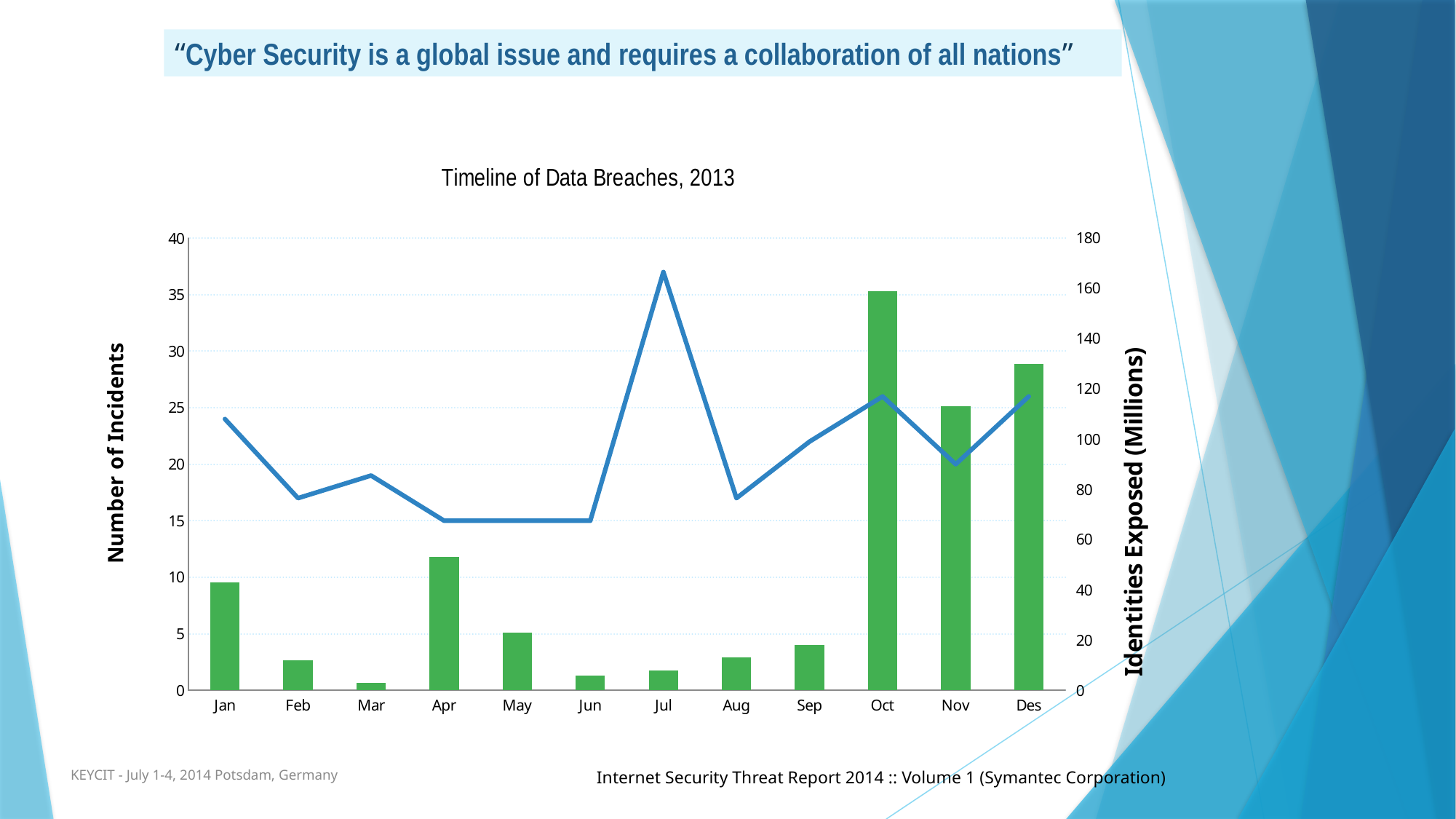
Does the line rise or fall from Jul to Aug? fall What kind of chart is shown on the slide? A combination bar and line chart Which month has the shortest bar in the chart? Mar What is the label of the left-hand vertical axis? Number of Incidents Which month has the tallest bar in the chart? Oct Which month has the taller bar, Nov or Des? Des In which month does the line reach its highest point? Jul Which month has the higher line value, Jan or Feb? Jan Is the bar for Oct greater or less than 140 on the right-hand axis? greater What is the title of the chart? Timeline of Data Breaches, 2013 Is the line value for Jul greater or less than 35 on the left-hand axis? greater How many months are shown along the x axis of the chart? 12